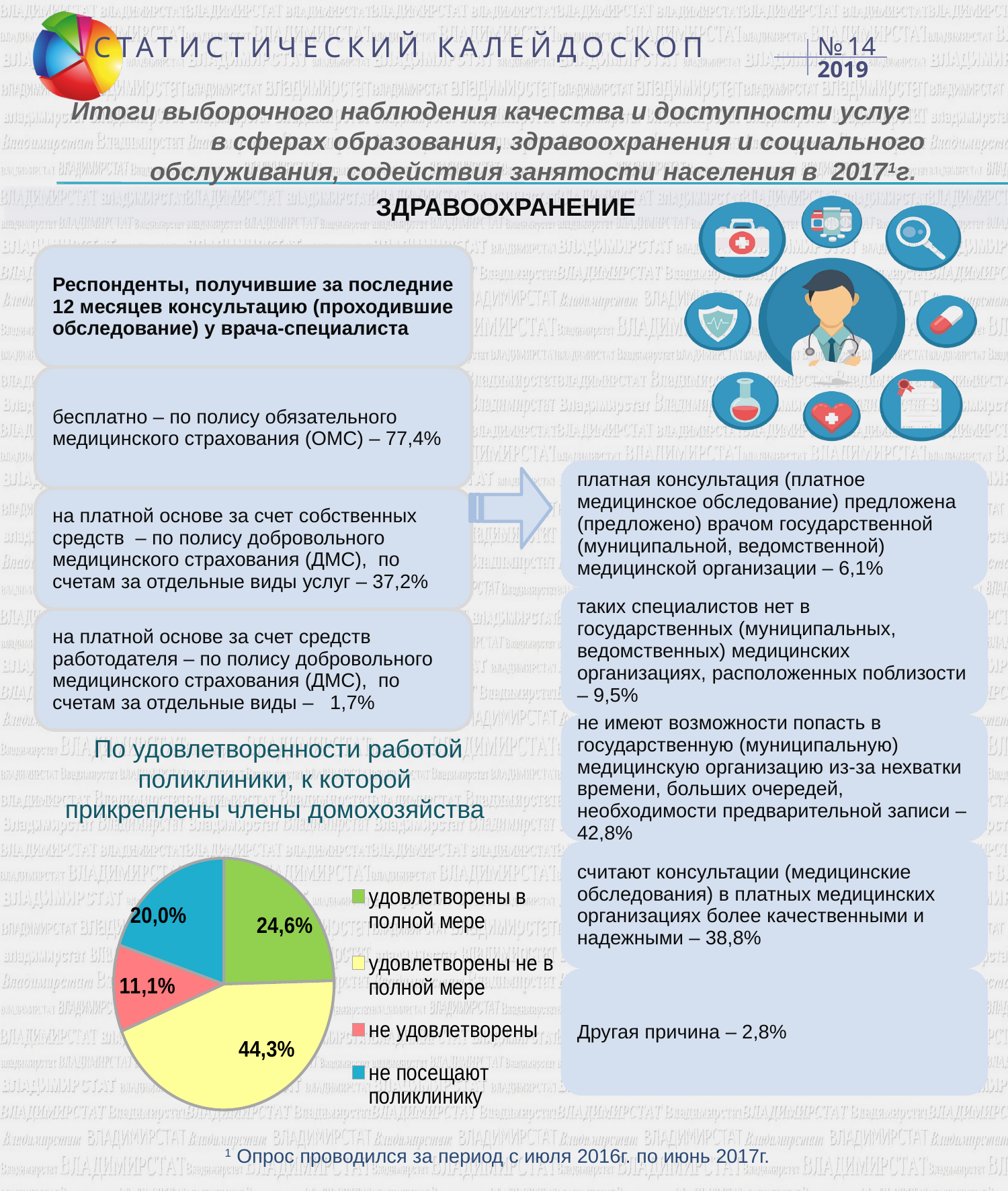
Каким цветом на диаграмме обозначена категория «не посещают поликлинику»? синим Какая доля респондентов не посещает поликлинику? 20,0% Какая доля респондентов удовлетворена работой поликлиники не в полной мере? 44,3% Каким цветом на диаграмме обозначена категория «удовлетворены в полной мере»? зелёным Какая доля респондентов не удовлетворена работой поликлиники? 11,1% Сколько категорий показано на круговой диаграмме? 4 Какая категория на круговой диаграмме имеет наибольшую долю? удовлетворены не в полной мере Какая доля респондентов удовлетворена работой поликлиники в полной мере? 24,6% На сколько процентных пунктов доля «удовлетворены не в полной мере» больше доли «удовлетворены в полной мере»? 19,7 Какая категория на круговой диаграмме имеет наименьшую долю? не удовлетворены Что больше: доля «не посещают поликлинику» или доля «не удовлетворены»? не посещают поликлинику Какой тип диаграммы показан на слайде? круговая диаграмма